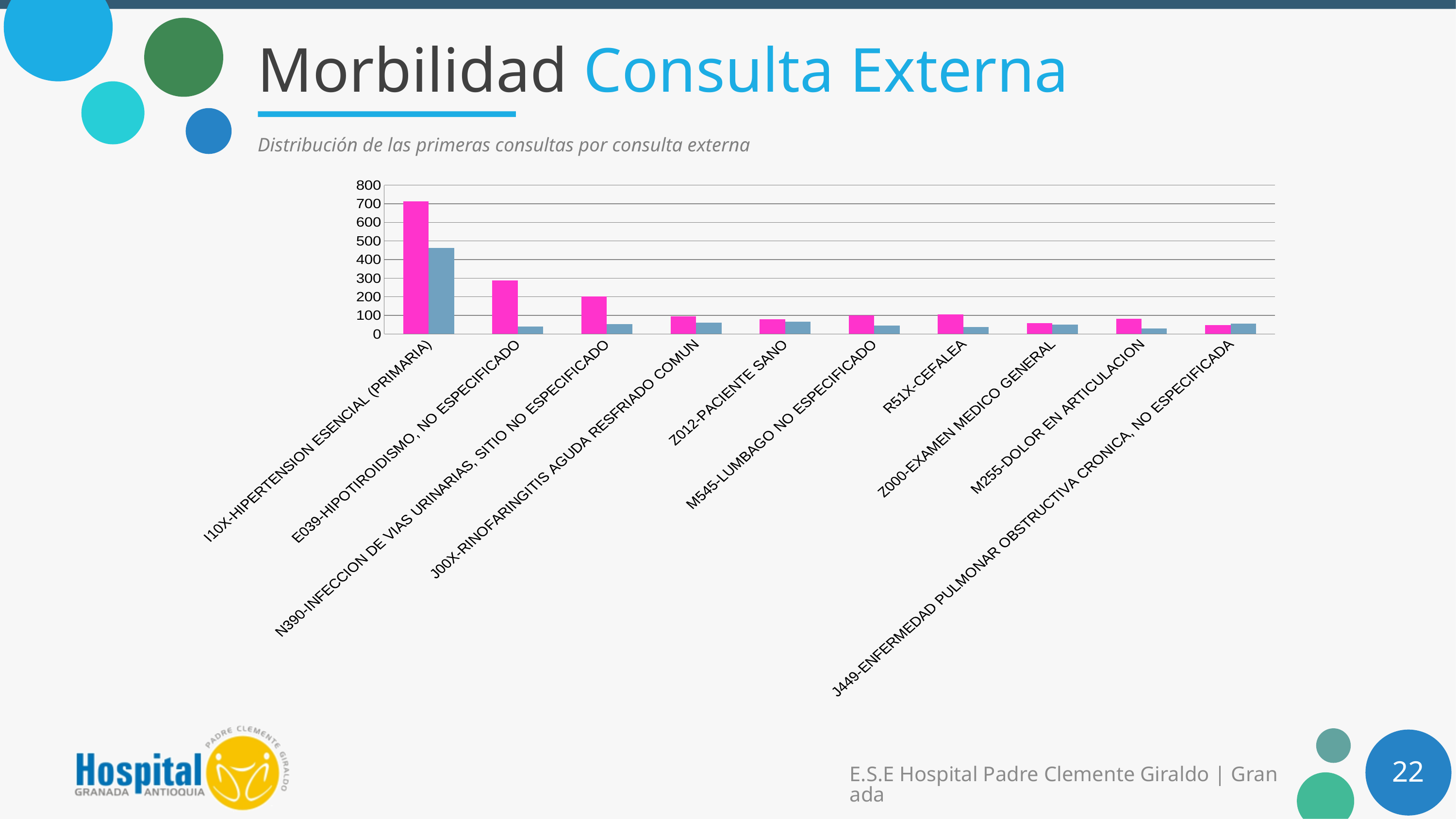
Is the blue-grey bar for I10X-HIPERTENSION ESENCIAL (PRIMARIA) greater or less than 400? greater How many categories (diagnoses) are shown on the x axis of the chart? 10 Which category has the highest pink bar in the chart? I10X-HIPERTENSION ESENCIAL (PRIMARIA) Is the pink bar for I10X-HIPERTENSION ESENCIAL (PRIMARIA) greater or less than 600? greater Is the blue-grey bar for I10X-HIPERTENSION ESENCIAL (PRIMARIA) greater or less than 500? less What kind of chart is shown on the slide? bar chart What is the subtitle written below the slide title, above the chart? Distribución de las primeras consultas por consulta externa Which pink bar is larger, E039-HIPOTIROIDISMO, NO ESPECIFICADO or N390-INFECCION DE VIAS URINARIAS, SITIO NO ESPECIFICADO? E039-HIPOTIROIDISMO, NO ESPECIFICADO For I10X-HIPERTENSION ESENCIAL (PRIMARIA), which bar is larger, the pink one or the blue-grey one? the pink one